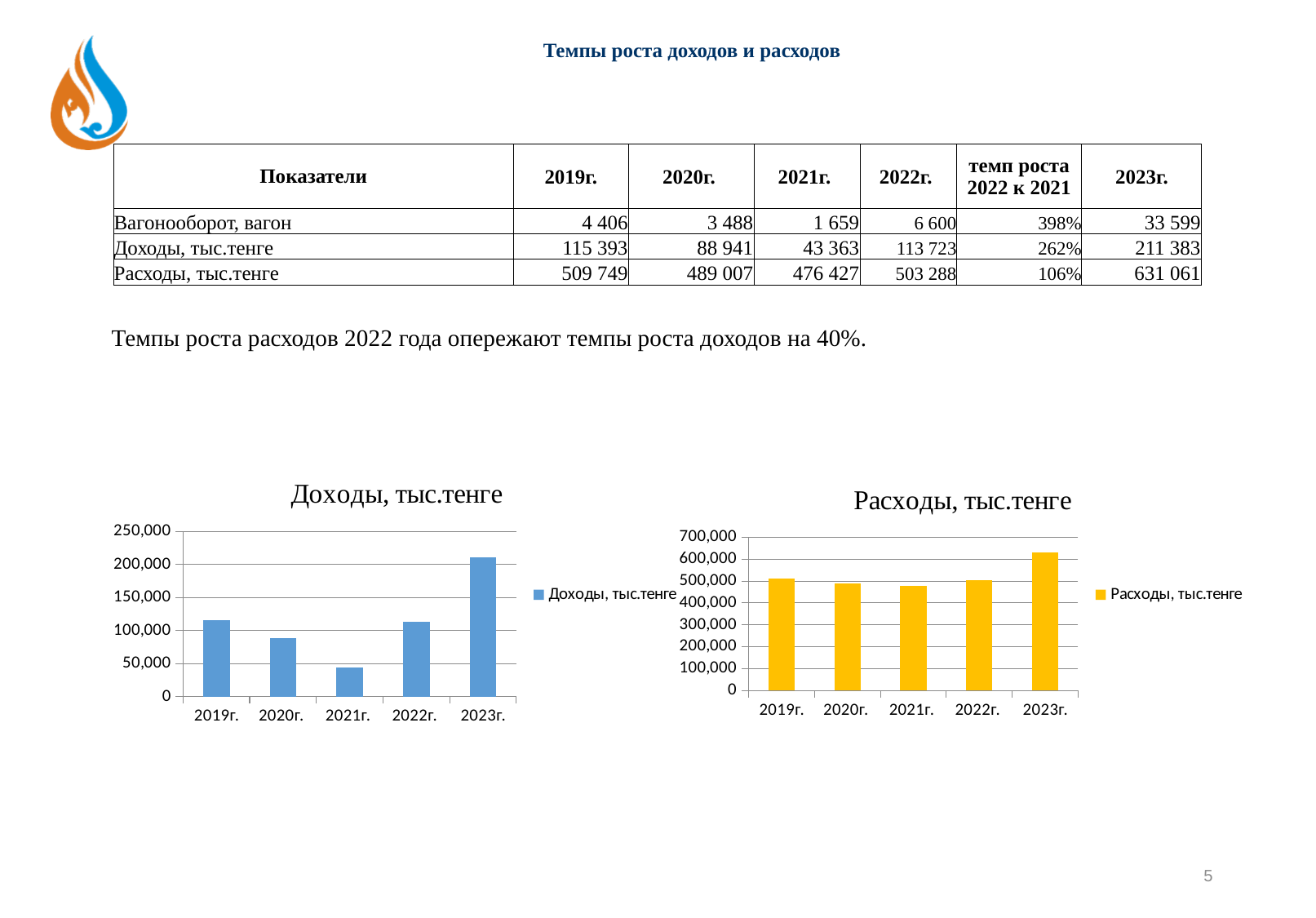
In the "Доходы, тыс.тенге" chart, which is larger, the value for 2020г. or the value for 2022г.? 2022г. How many years are shown on the x axis of the "Доходы, тыс.тенге" chart? 5 In the "Доходы, тыс.тенге" chart, do the values rise or fall from 2019г. to 2021г.? fall In the "Доходы, тыс.тенге" chart, which year has the lowest value? 2021г. In the "Доходы, тыс.тенге" chart, which year has the highest value? 2023г. In the "Расходы, тыс.тенге" chart, which year has the highest value? 2023г. In the "Расходы, тыс.тенге" chart, is the value for 2023г. greater or less than 600,000? greater What is the legend entry of the "Расходы, тыс.тенге" chart? Расходы, тыс.тенге How many series does the legend of the "Расходы, тыс.тенге" chart list? 1 In the "Доходы, тыс.тенге" chart, is the value for 2021г. greater or less than 50,000? less What kind of chart is the "Доходы, тыс.тенге" chart? bar chart In the "Доходы, тыс.тенге" chart, is the value for 2019г. greater or less than 100,000? greater